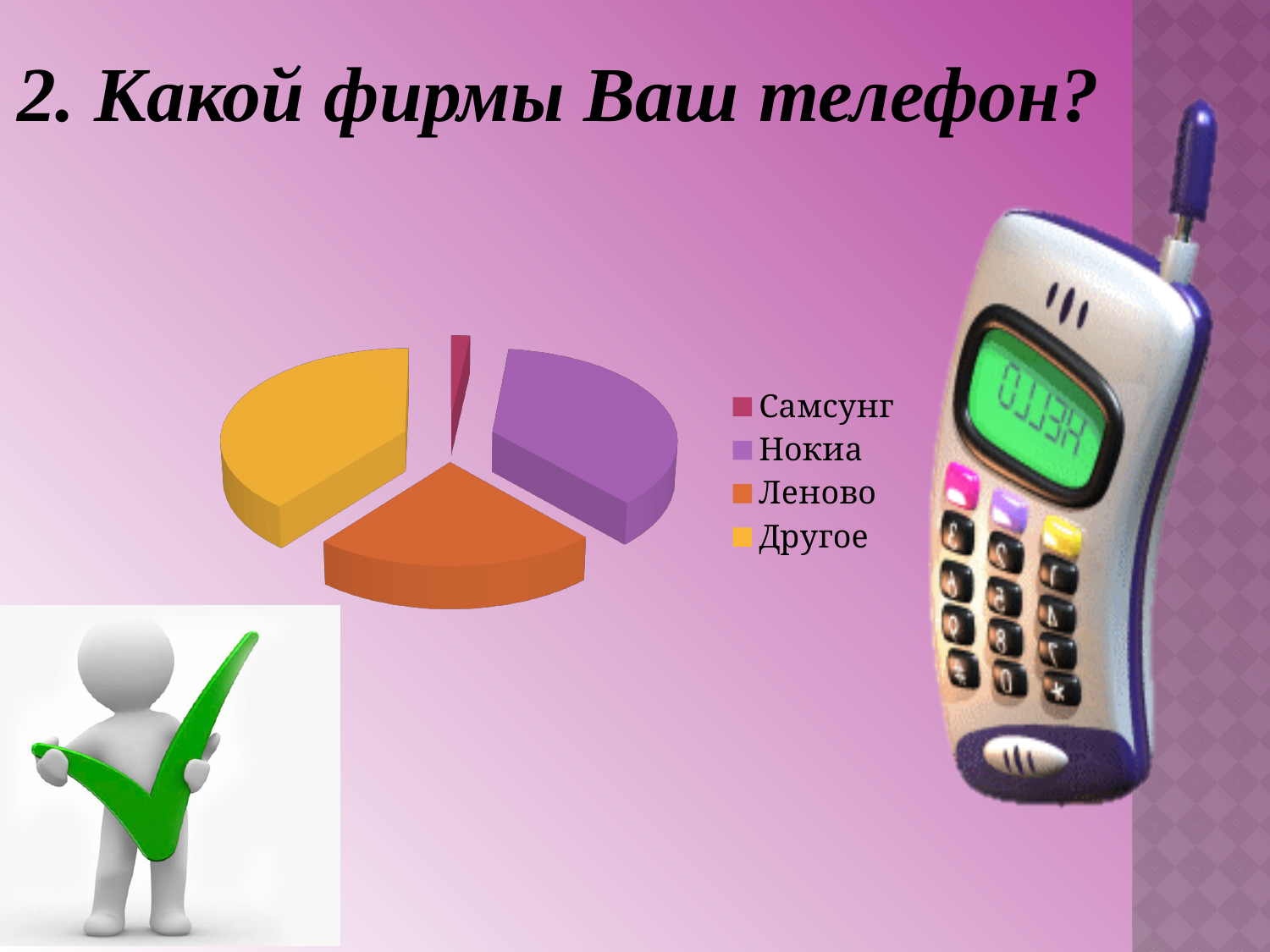
Which category has the smallest slice in the pie chart? Самсунг What colour is the Самсунг slice in the pie chart? red How many slices does the pie chart have? 4 Which slice is larger in the pie chart, Самсунг or Другое? Другое What are the legend entries of the pie chart, in order? Самсунг, Нокиа, Леново, Другое Which slice is larger in the pie chart, Самсунг or Леново? Леново Which slice is larger in the pie chart, Самсунг or Нокиа? Нокиа What kind of chart is shown on the slide? pie chart How many entries does the legend of the pie chart list? 4